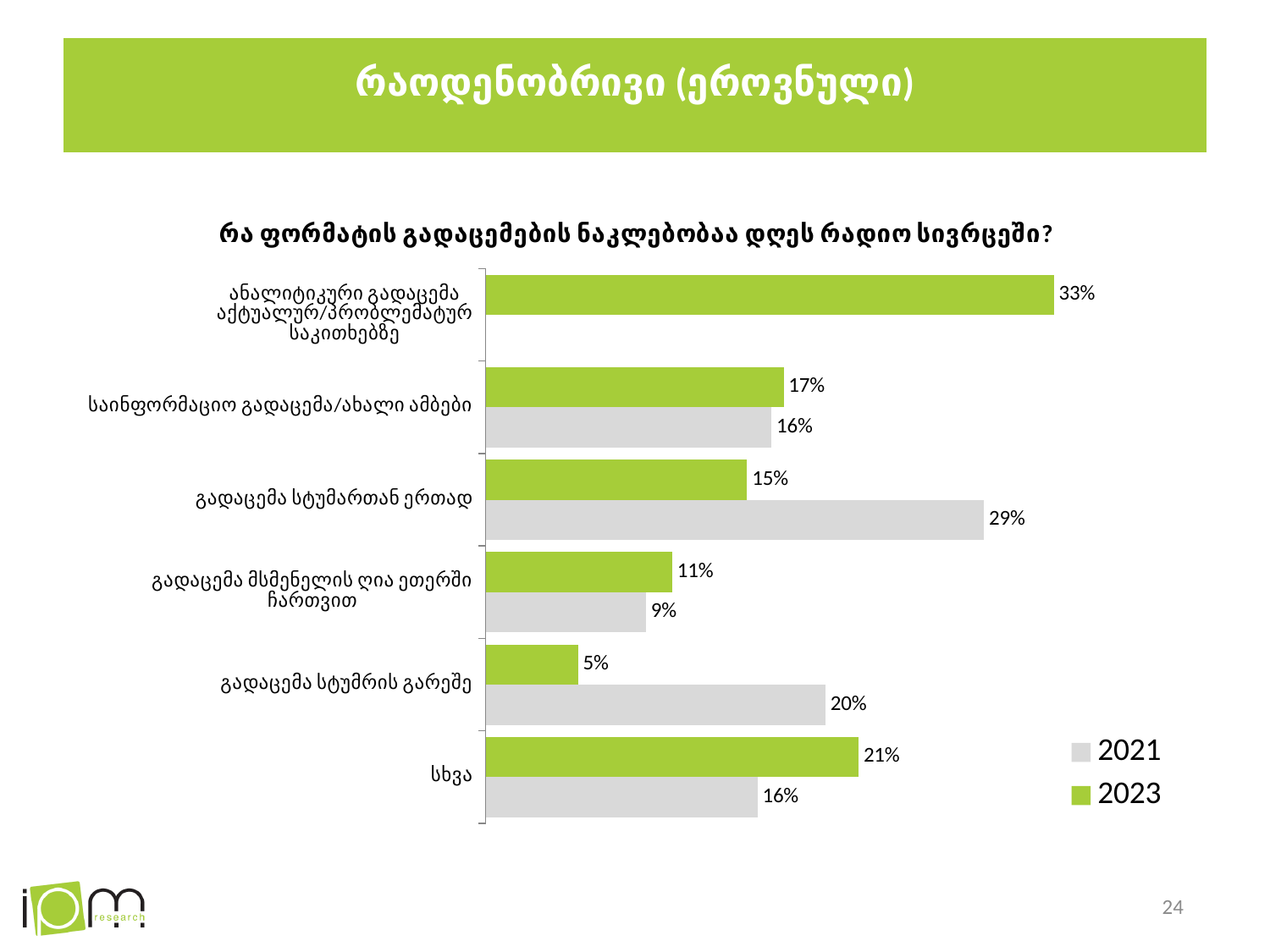
How many categories are shown on the chart? 6 What is the difference between the 2021 and 2023 values for "გადაცემა სტუმრის გარეშე"? 15% Which category has the lowest 2023 value? გადაცემა სტუმრის გარეშე What is the 2021 value for "გადაცემა სტუმართან ერთად"? 29% What kind of chart is shown on the slide? Bar chart Which category has the lowest 2021 value? გადაცემა მსმენელის ღია ეთერში ჩართვით How many series does the legend list? 2 What is the 2023 value for "ანალიტიკური გადაცემა აქტუალურ/პრობლემატურ საკითხებზე"? 33% For "გადაცემა სტუმართან ერთად", which year has the larger value, 2021 or 2023? 2021 What is the 2021 value for "სხვა"? 16% Which category has the highest 2023 value? ანალიტიკური გადაცემა აქტუალურ/პრობლემატურ საკითხებზე What is the 2023 value for "გადაცემა სტუმრის გარეშე"? 5%